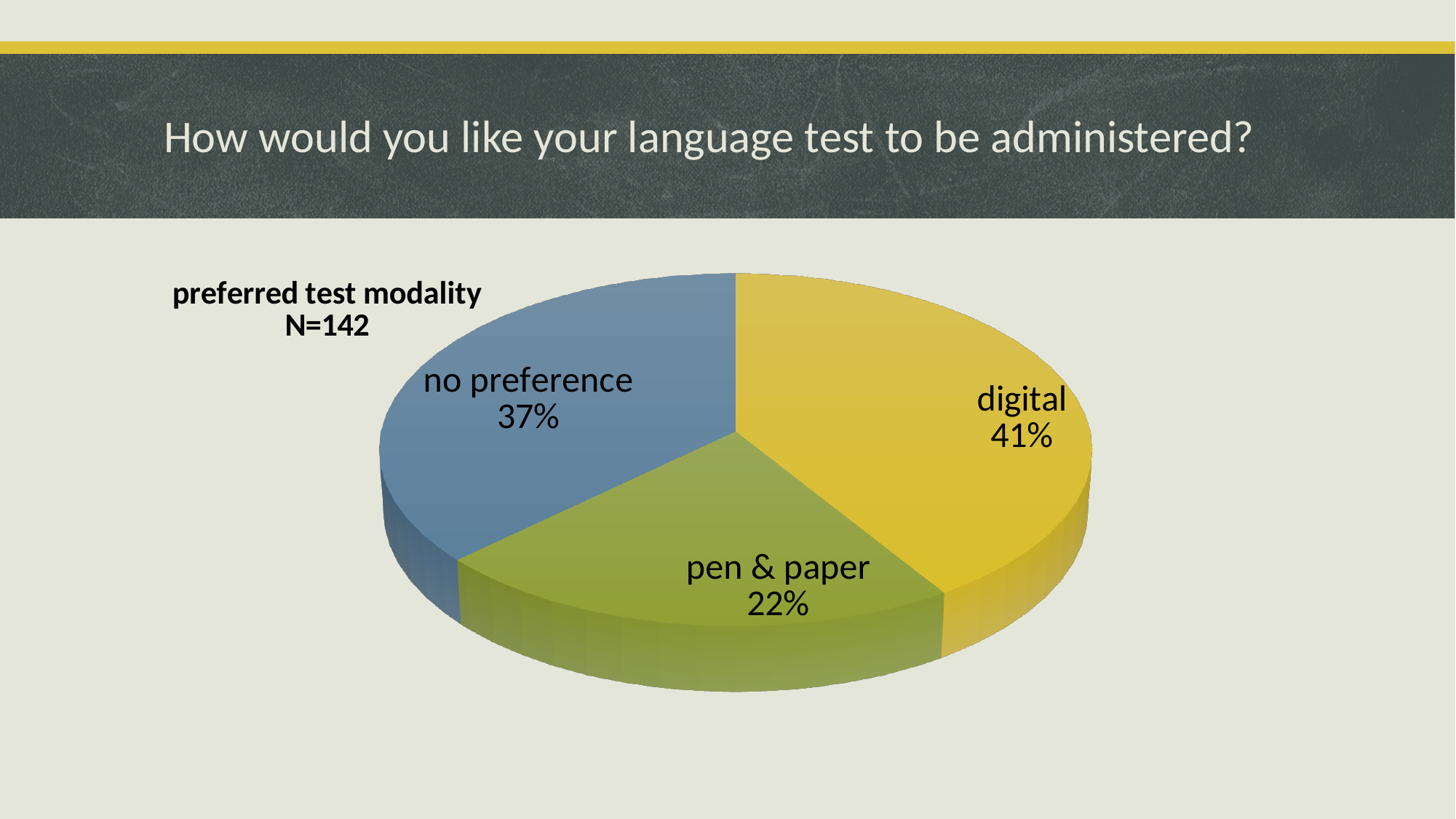
Which slice is larger, 'no preference' or 'pen & paper'? no preference What share of the pie does the 'digital' slice represent? 41% What colour is the 'digital' slice of the pie chart? yellow What is the difference in percentage points between the 'no preference' and 'pen & paper' slices? 15 Which test modality has the smallest share of the pie? pen & paper What share of the pie does the 'pen & paper' slice represent? 22% Which test modality has the largest share of the pie? digital How many slices does the pie chart have? 3 What is the difference in percentage points between the 'digital' and 'pen & paper' slices? 19 What is the title of the pie chart? preferred test modality N=142 What kind of chart is shown on the slide? pie chart What share of the pie does the 'no preference' slice represent? 37%